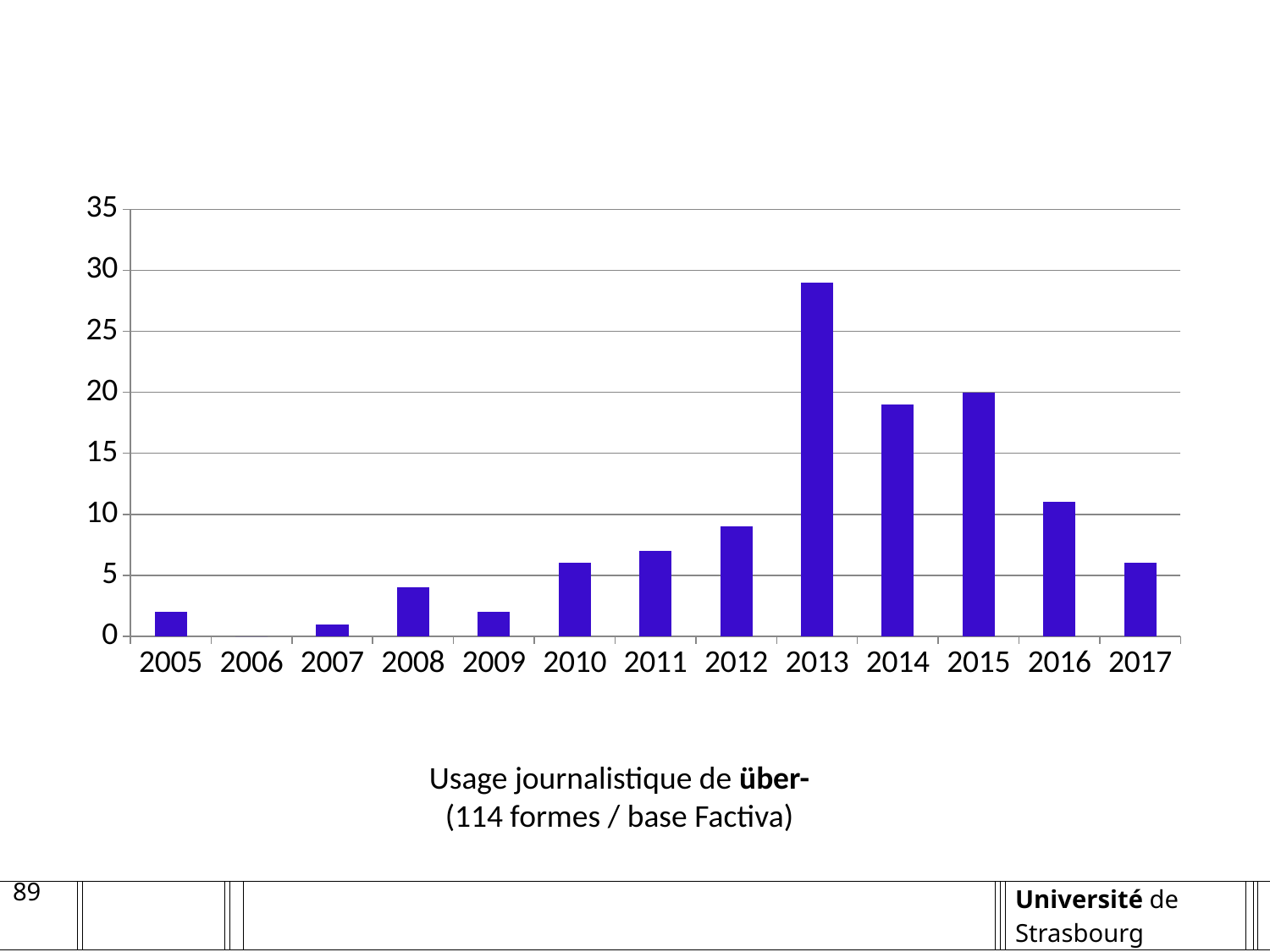
Which year has the highest bar in the chart? 2013 Which year has the larger value, 2016 or 2017? 2016 Is the value for 2016 greater or less than 10? greater What is the value for 2015 in the chart? 20 What is the caption shown below the chart? Usage journalistique de über- (114 formes / base Factiva) Which year has the lowest value in the chart? 2006 Do the values rise or fall from 2009 to 2013? rise How many years are shown on the x axis of the chart? 13 What is the value for 2006 in the chart? 0 Is the value for 2013 greater or less than 25? greater What kind of chart is shown on the slide? bar chart Is the value for 2014 greater or less than 20? less